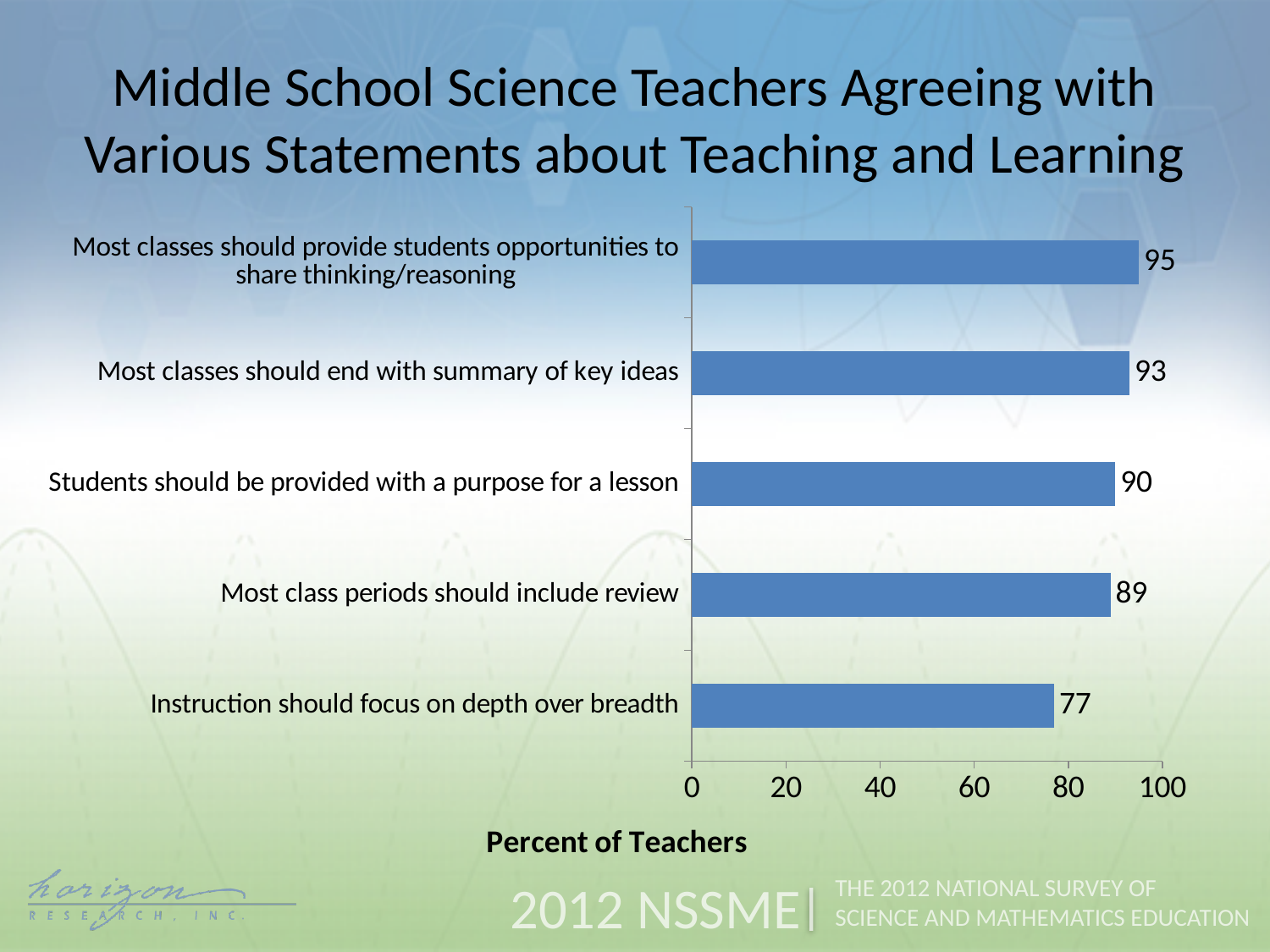
What is the label of the horizontal axis? Percent of Teachers Which statement has the highest percent of teachers agreeing? Most classes should provide students opportunities to share thinking/reasoning Is the value for 'Instruction should focus on depth over breadth' greater or less than 80? less Which statement has the lowest percent of teachers agreeing? Instruction should focus on depth over breadth What is the difference between the values for 'Most classes should end with summary of key ideas' and 'Instruction should focus on depth over breadth'? 16 What percent of teachers agree that instruction should focus on depth over breadth? 77 How many statements are shown in the chart? 5 What kind of chart is shown on the slide? bar chart What is the value for 'Most class periods should include review'? 89 What percent of teachers agree that most classes should provide students opportunities to share thinking/reasoning? 95 What is the value for 'Students should be provided with a purpose for a lesson'? 90 Which is larger: the value for 'Most classes should end with summary of key ideas' or 'Most class periods should include review'? Most classes should end with summary of key ideas